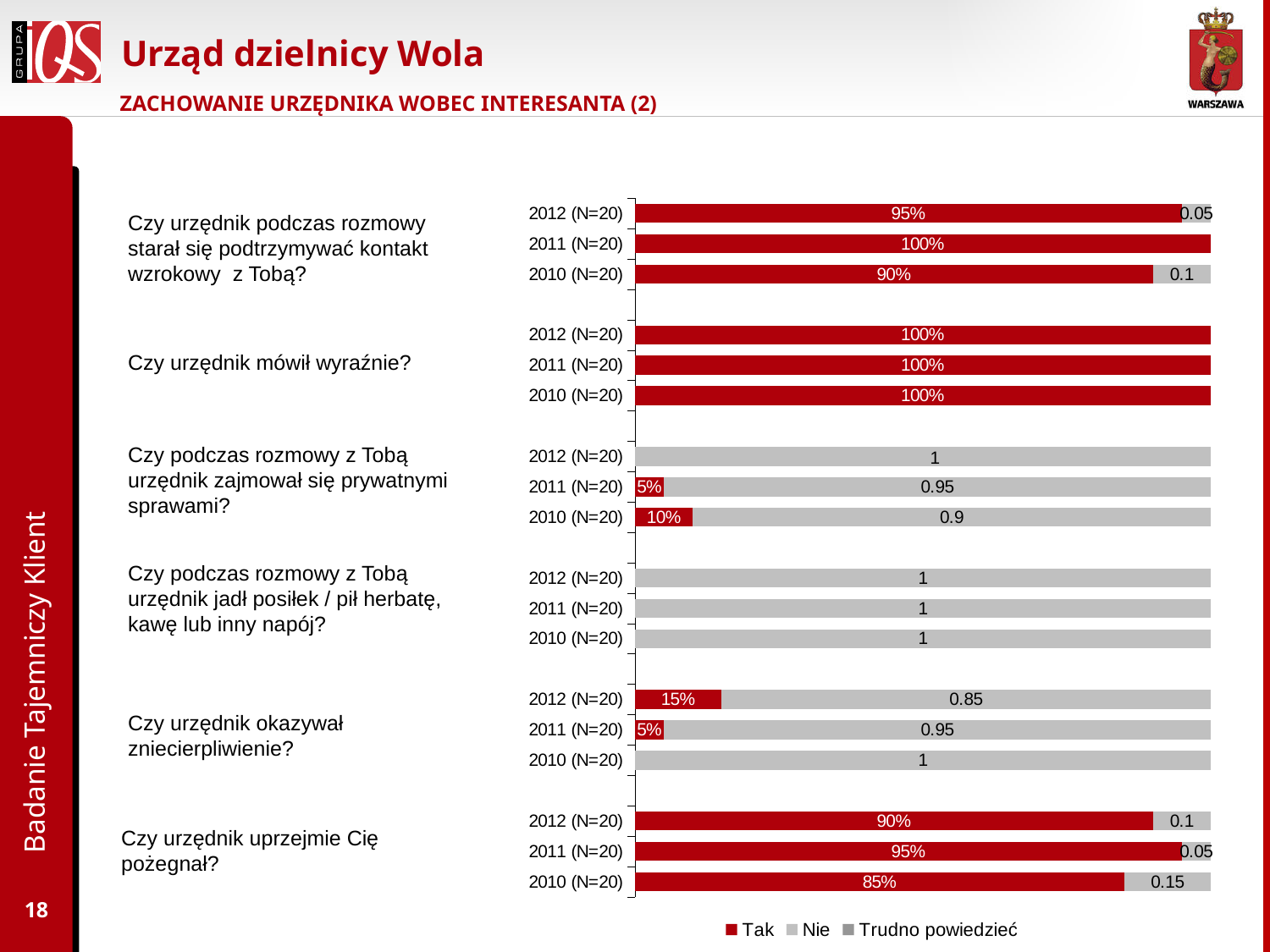
For the question 'Czy urzędnik uprzejmie Cię pożegnał?', what is the 'Tak' value for 2010 (N=20)? 85% For the question 'Czy urzędnik mówił wyraźnie?', what is the 'Tak' value for 2011 (N=20)? 100% What kind of chart is shown on the slide? stacked bar chart For the question 'Czy urzędnik uprzejmie Cię pożegnał?', which year has the highest 'Tak' value? 2011 (N=20) For the question 'Czy urzędnik okazywał zniecierpliwienie?', what is the 'Tak' value for 2012 (N=20)? 15% For the question 'Czy urzędnik uprzejmie Cię pożegnał?', what is the difference between the 'Tak' values for 2011 (N=20) and 2010 (N=20)? 10% For the question 'Czy urzędnik podczas rozmowy starał się podtrzymywać kontakt wzrokowy z Tobą?', what is the 'Tak' value for 2012 (N=20)? 95% For the question 'Czy urzędnik podczas rozmowy starał się podtrzymywać kontakt wzrokowy z Tobą?', what is the 'Tak' value for 2010 (N=20)? 90% What are the series names listed in the chart legend? Tak, Nie, Trudno powiedzieć How many series does the chart legend list? 3 For the question 'Czy podczas rozmowy z Tobą urzędnik zajmował się prywatnymi sprawami?', what is the 'Tak' value for 2010 (N=20)? 10% For the question 'Czy urzędnik okazywał zniecierpliwienie?', what is the 'Nie' value for 2011 (N=20)? 0.95